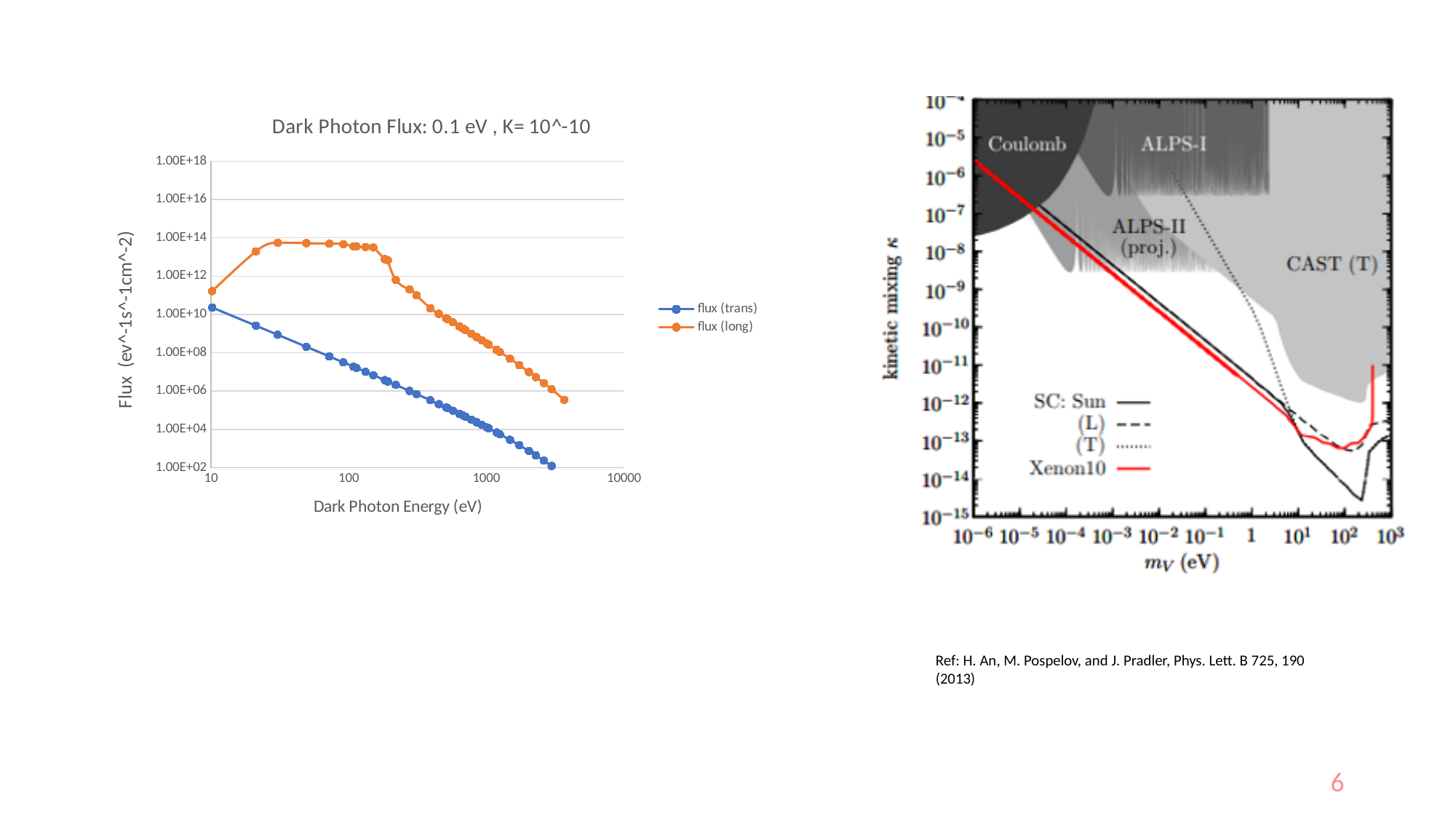
On the left chart, does the flux (trans) series rise or fall as Dark Photon Energy increases? Fall On the right chart, is the Xenon10 curve at m_V = 10^-6 eV greater or less than 10^-7? greater On the left chart, is the peak flux (long) value greater or less than 1.00E+12? greater On the left chart titled 'Dark Photon Flux: 0.1 eV , K= 10^-10', how many series does the legend list? 2 On the left chart, which series has the higher flux at 100 eV, flux (trans) or flux (long)? flux (long) What is the x-axis title of the left chart? Dark Photon Energy (eV) On the left chart, is the flux (long) value at 10 eV greater or less than 1.00E+10? greater On the right chart of kinetic mixing versus m_V, which legend entry is drawn as a red line? Xenon10 What kind of chart is the left chart titled 'Dark Photon Flux: 0.1 eV , K= 10^-10'? Line chart On the left chart, which series reaches the lowest flux value at the high-energy end? flux (trans)